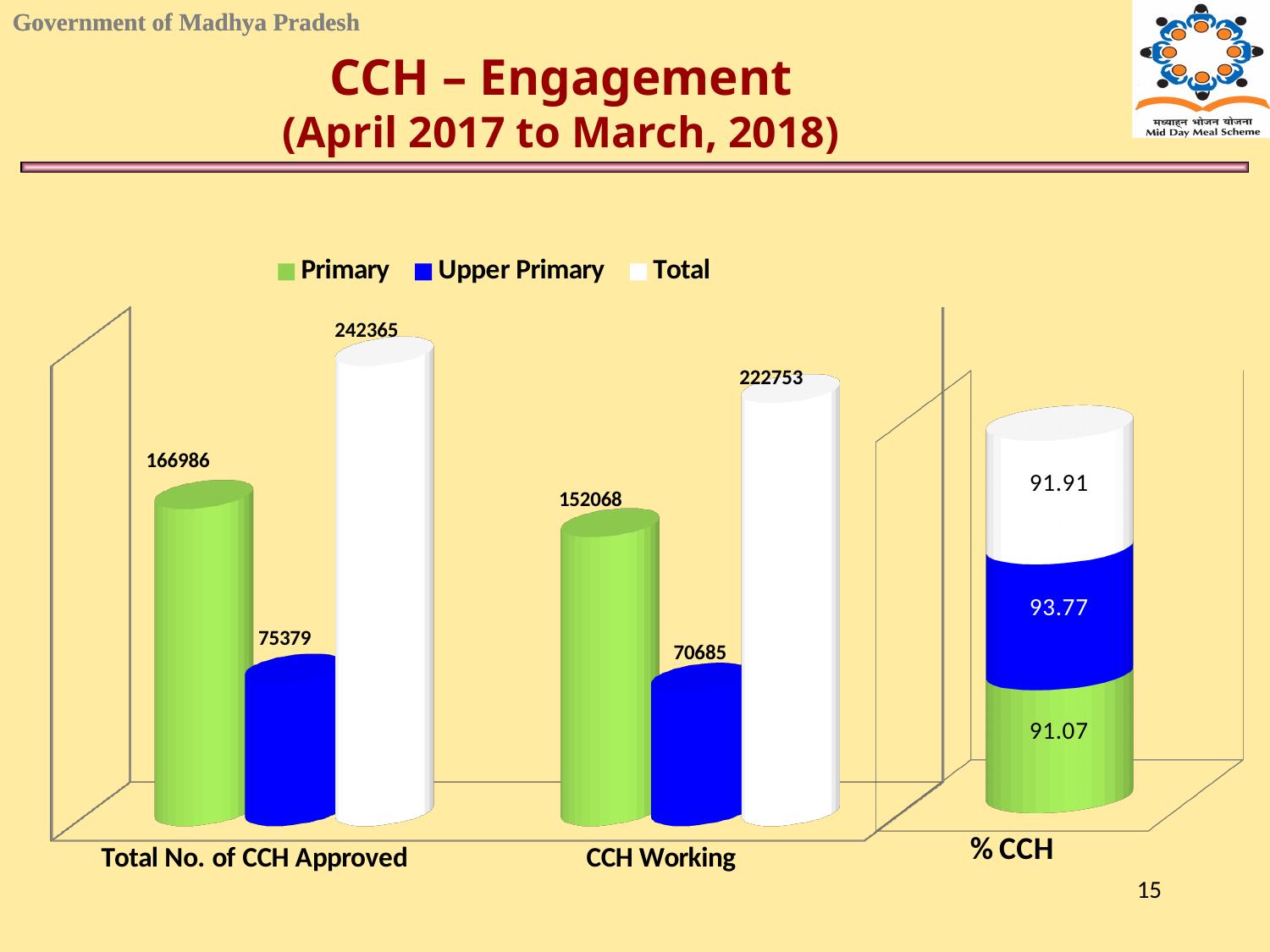
What is the Primary value shown in the % CCH bar? 91.07 What is the Total value for Total No. of CCH Approved? 242365 What is the difference between the Total values for Total No. of CCH Approved and CCH Working? 19612 Which series has the lowest value for Total No. of CCH Approved? Upper Primary What is the Primary value for Total No. of CCH Approved? 166986 What kind of chart is shown on the slide? Bar chart How many series does the legend list? 3 Which is larger: the Primary value for Total No. of CCH Approved or the Primary value for CCH Working? Total No. of CCH Approved What is the Upper Primary value for CCH Working? 70685 What is the Total value for CCH Working? 222753 What is the Upper Primary value shown in the % CCH bar? 93.77 How many categories are shown on the x axis? 3